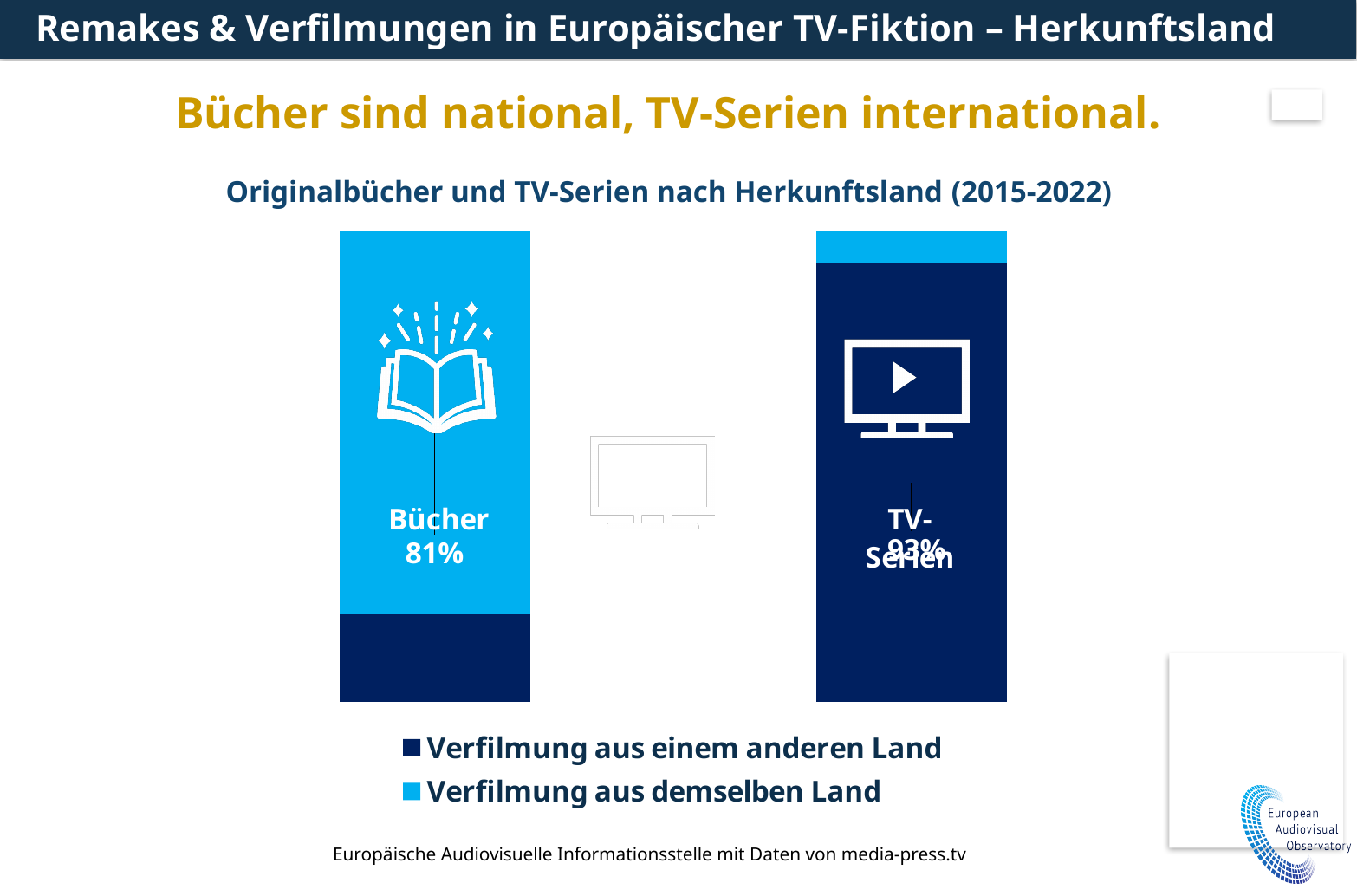
Which category has the highest share of 'Verfilmung aus demselben Land'? Bücher How many categories are shown on the x axis of the chart? 2 What share of Bücher is labelled as 'Verfilmung aus demselben Land'? 81% Which category has the larger share of 'Verfilmung aus einem anderen Land', Bücher or TV-Serien? TV-Serien How many series does the chart's legend list? 2 Which category has the larger share of 'Verfilmung aus demselben Land', Bücher or TV-Serien? Bücher What kind of chart is shown on the slide? Stacked bar chart What are the two legend entries of the chart? Verfilmung aus einem anderen Land; Verfilmung aus demselben Land Which category has the lowest share of 'Verfilmung aus einem anderen Land'? Bücher What is the title of the chart? Originalbücher und TV-Serien nach Herkunftsland (2015-2022)